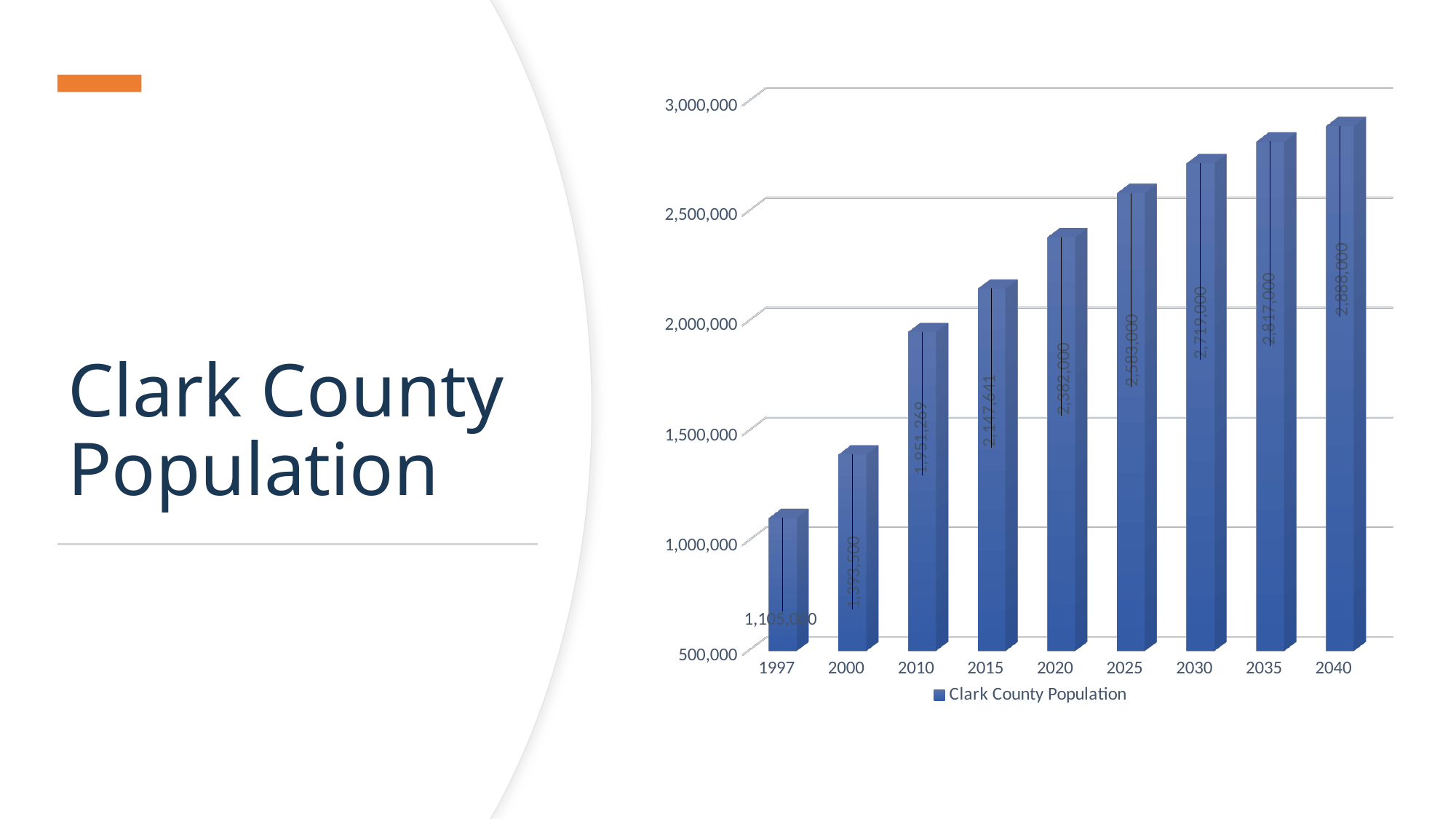
Which year has the highest population? 2040 How many years are shown on the x axis? 9 Which year has the lowest population? 1997 What is the value for 2030? 2,719,000 What is the value for 2010? 1,951,269 What is the value for 2040? 2,888,000 Which is larger, the value for 2025 or the value for 2015? 2025 Do the values rise or fall from 1997 to 2040? rise Is the value for 1997 greater or less than 1,500,000? less What is the value for 2020? 2,382,000 What kind of chart is this? bar chart What is the difference between the values for 2040 and 2035? 71,000